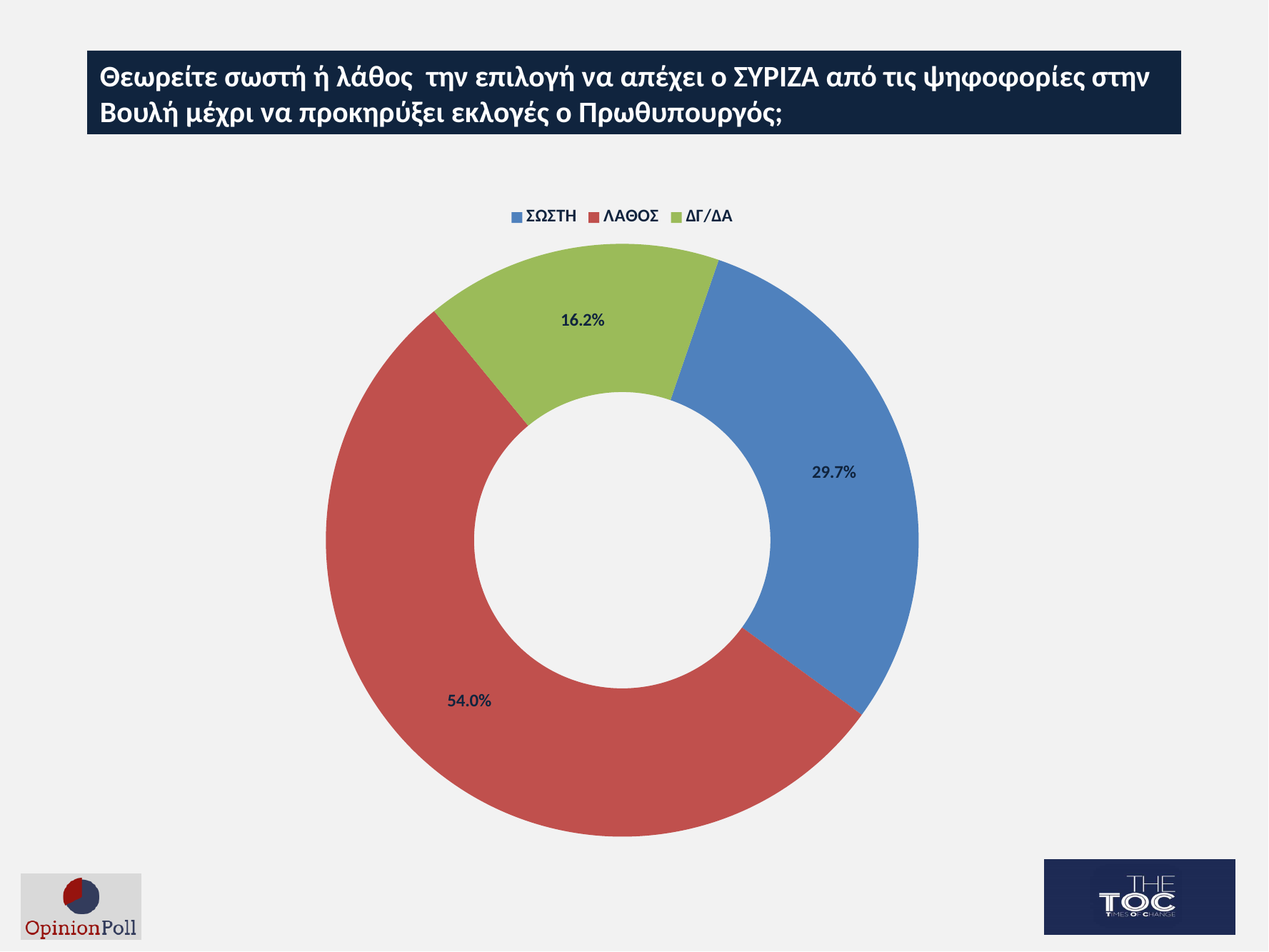
Which response has the smallest share of the chart? ΔΓ/ΔΑ What colour represents ΛΑΘΟΣ in the chart? Red What kind of chart is shown on the slide? Doughnut (pie) chart How many entries does the legend list? 3 What percentage of respondents answered ΛΑΘΟΣ? 54.0% What is the difference in percentage points between ΣΩΣΤΗ and ΔΓ/ΔΑ? 13.5 How many categories are shown in the chart? 3 Which is larger, the share for ΣΩΣΤΗ or the share for ΔΓ/ΔΑ? ΣΩΣΤΗ What is the difference in percentage points between ΛΑΘΟΣ and ΣΩΣΤΗ? 24.3 What percentage of respondents answered ΣΩΣΤΗ? 29.7% Which response has the largest share of the chart? ΛΑΘΟΣ What percentage of respondents answered ΔΓ/ΔΑ? 16.2%